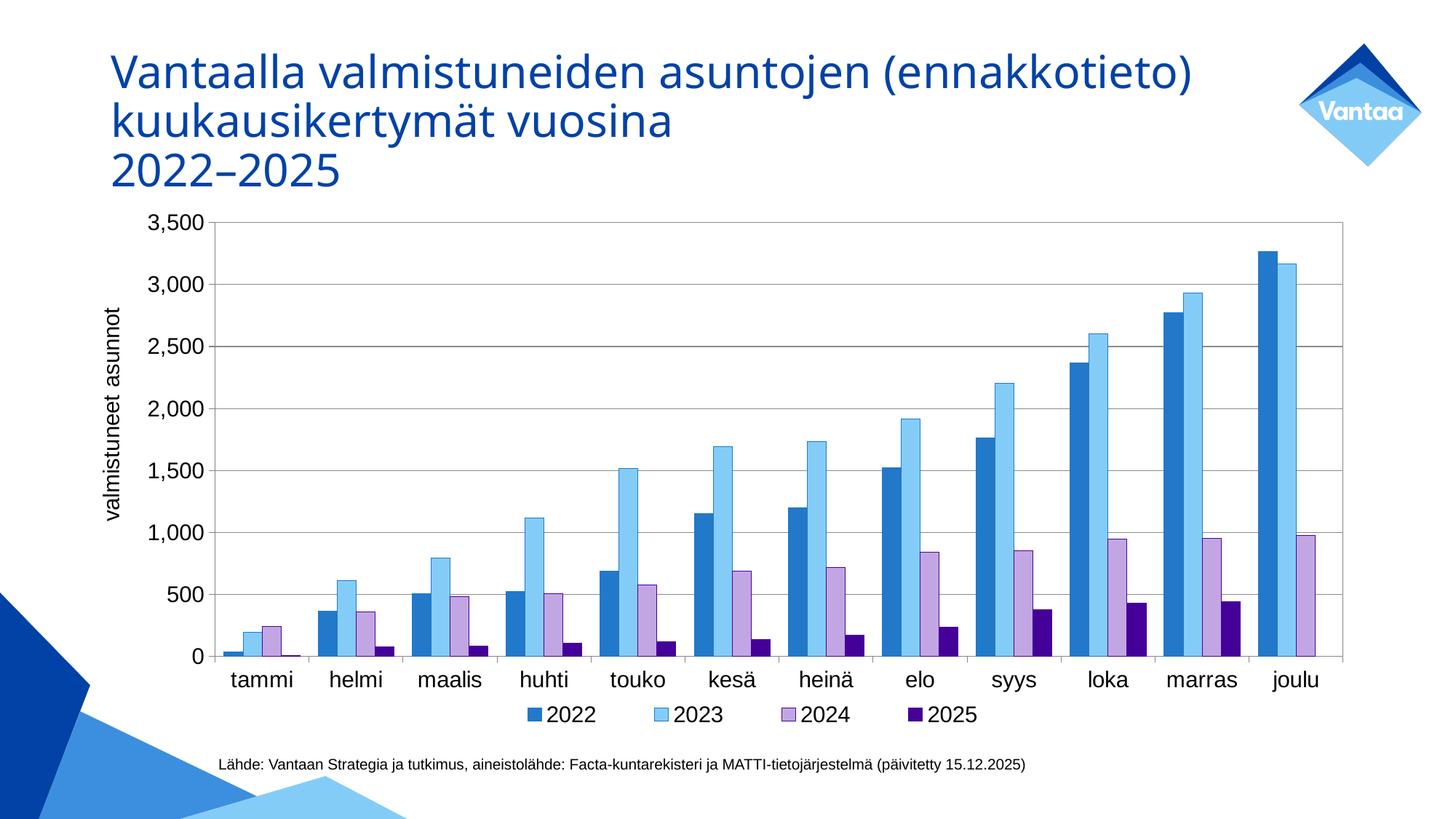
Is the value for 2022 in joulu greater or less than 3,000? greater Is the value for 2023 in syys greater or less than 2,000? greater Is the value for 2023 in tammi greater or less than 500? less In loka, which series has the larger value, 2022 or 2023? 2023 What kind of chart is shown on the slide? bar chart How many series does the legend list? 4 How many months are shown on the x axis? 12 What is the label on the y axis? valmistuneet asunnot Which month has the lowest value for the 2022 series? tammi Do the values for the 2024 series rise or fall from tammi to joulu? rise Which month has the highest value for the 2023 series? joulu